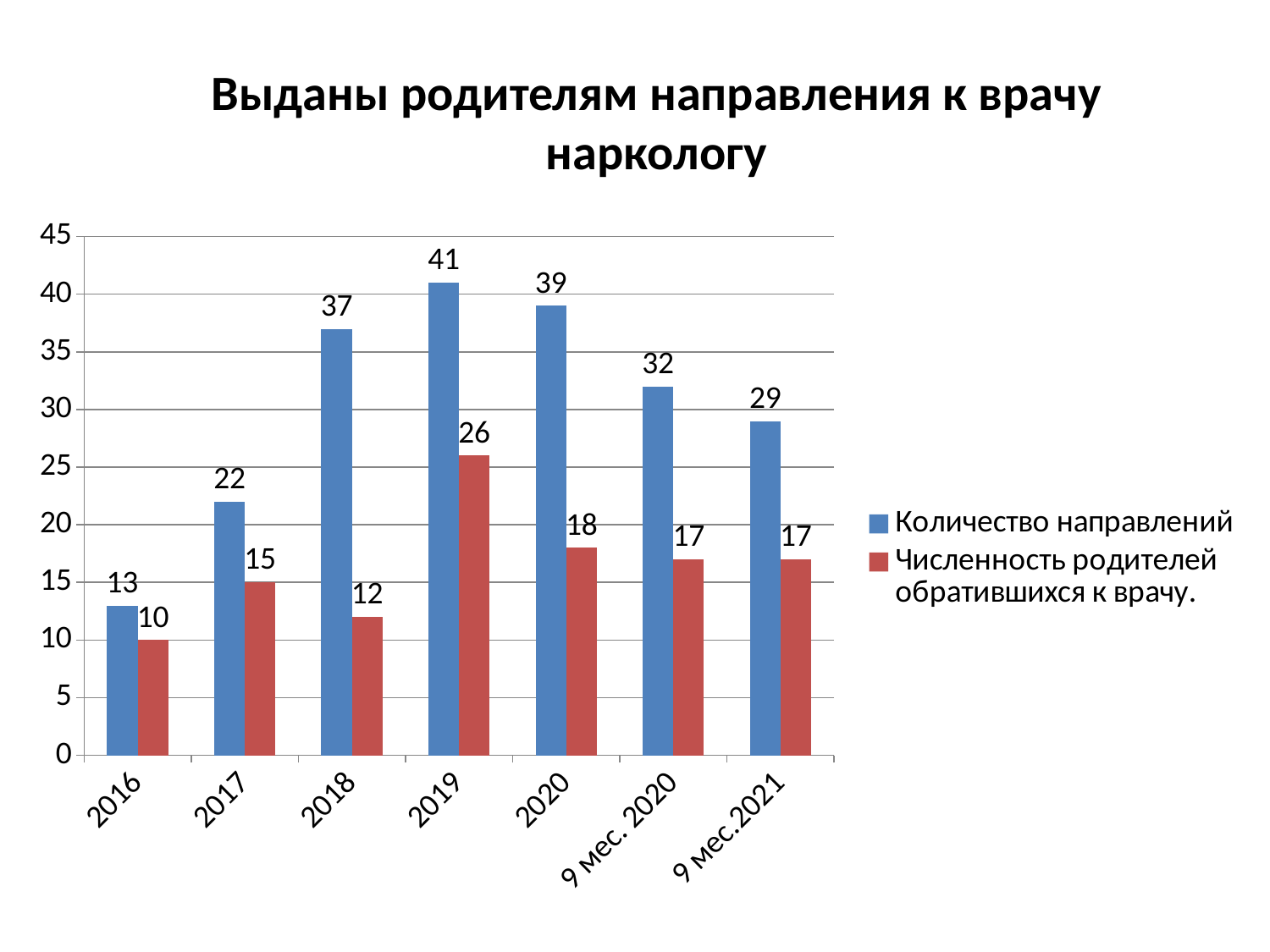
What is the value of 'Количество направлений' for 2019? 41 What is the title of the chart? Выданы родителям направления к врачу наркологу How many series does the legend list? 2 Which category has the lowest value for 'Численность родителей обратившихся к врачу.'? 2016 What is the value of 'Численность родителей обратившихся к врачу.' for 2018? 12 Is the value of 'Численность родителей обратившихся к врачу.' for 2019 greater or less than 25? greater How many categories are shown on the x axis? 7 Which is larger: 'Количество направлений' in 2020 or in '9 мес. 2020'? 2020 What is the value of 'Количество направлений' for '9 мес.2021'? 29 What kind of chart is shown on the slide? Bar chart Which category has the highest value for 'Количество направлений'? 2019 What is the difference between 'Количество направлений' and 'Численность родителей обратившихся к врачу.' in 2018? 25